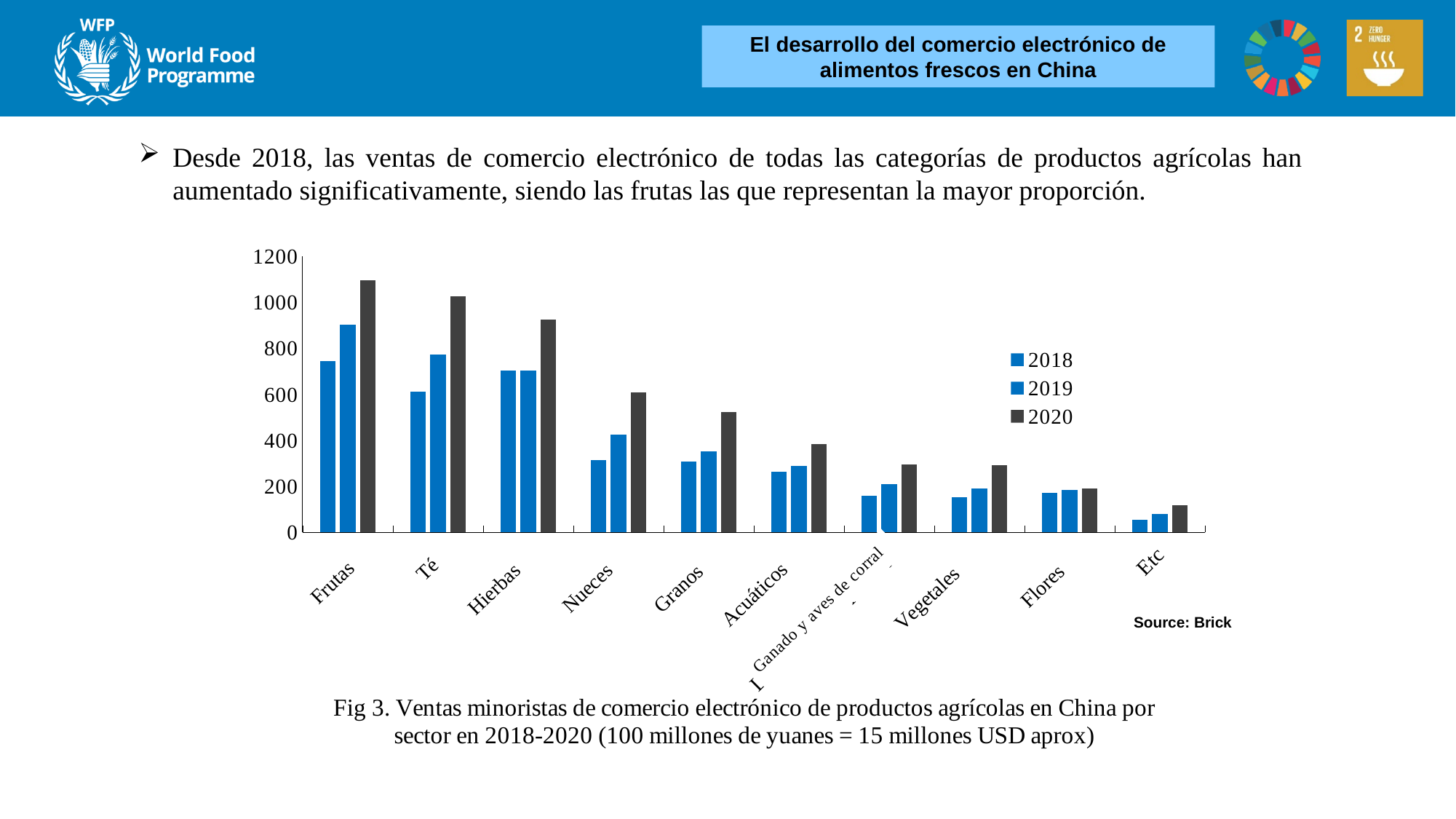
Is the value for Hierbas in 2020 greater or less than 1000? less Is the value for Granos in 2020 greater or less than 600? less What kind of chart is shown on the slide? bar chart Which category has the highest value for 2020? Frutas How many categories are shown on the x axis? 10 Which is larger, the 2020 value for Frutas or the 2020 value for Hierbas? Frutas Is the value for Etc in 2020 greater or less than 200? less How many series does the legend list? 3 Do the 2020 values generally rise or fall moving from left to right along the x axis? fall Which category has the lowest value for 2020? Etc What source is cited for the chart? Brick